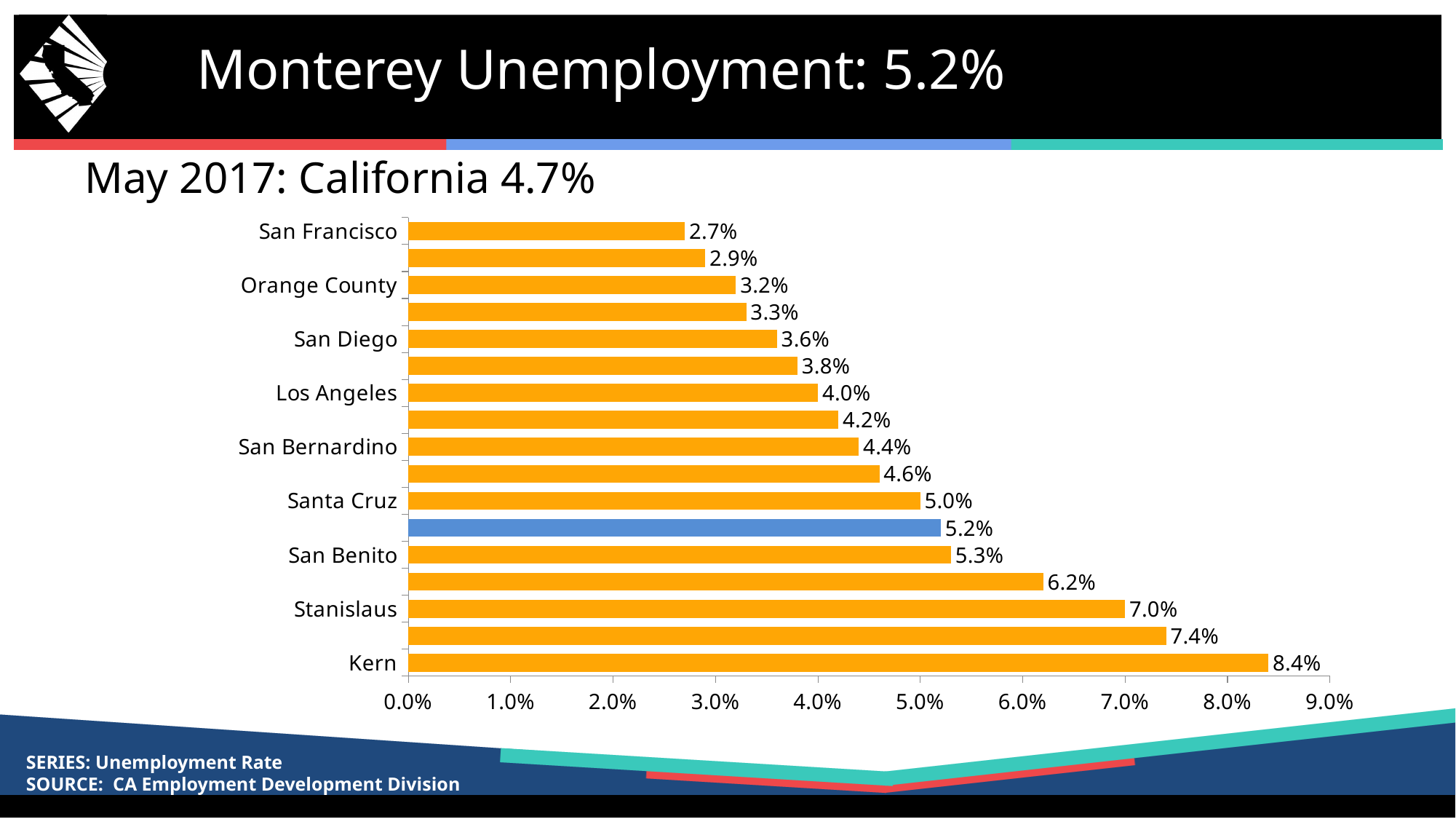
What kind of chart is shown on the slide? Bar chart Which labeled county has the lowest unemployment rate on the chart? San Francisco What is the unemployment rate shown for Santa Cruz? 5.0% What is the unemployment rate shown for Los Angeles? 4.0% How many bars are plotted on the chart? 17 What is the unemployment rate shown for San Francisco? 2.7% Which labeled county has the highest unemployment rate on the chart? Kern What is the difference between the unemployment rates of Kern and San Francisco? 5.7% What is the unemployment rate shown for Kern? 8.4% What value is shown on the blue bar in the chart? 5.2% What is the difference between the unemployment rates of Stanislaus and San Benito? 1.7% Which has a higher unemployment rate, San Diego or San Bernardino? San Bernardino